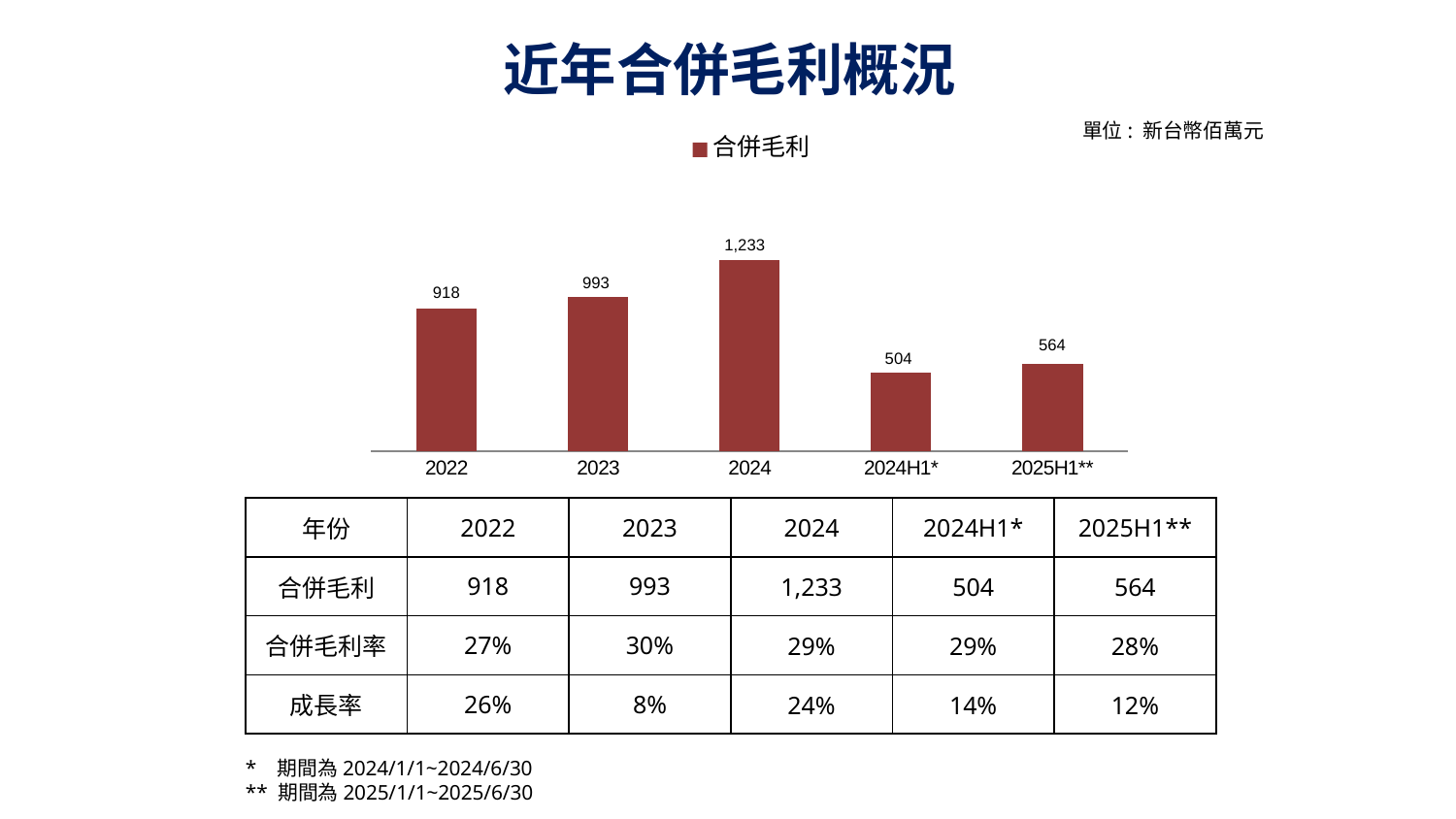
What is the 合併毛利 value for 2024? 1,233 What is the difference in 合併毛利 between 2024 and 2023? 240 Which is larger, the 合併毛利 for 2022 or for 2023? 2023 Which category has the lowest 合併毛利? 2024H1* What kind of chart is shown on the slide? Bar chart What is the 合併毛利 value for 2022? 918 How many series does the legend list? 1 What is the title of the slide? 近年合併毛利概況 What is the 合併毛利 value for 2025H1**? 564 What is the difference in 合併毛利 between 2025H1** and 2024H1*? 60 Which category has the highest 合併毛利? 2024 How many categories are shown on the x axis of the chart? 5